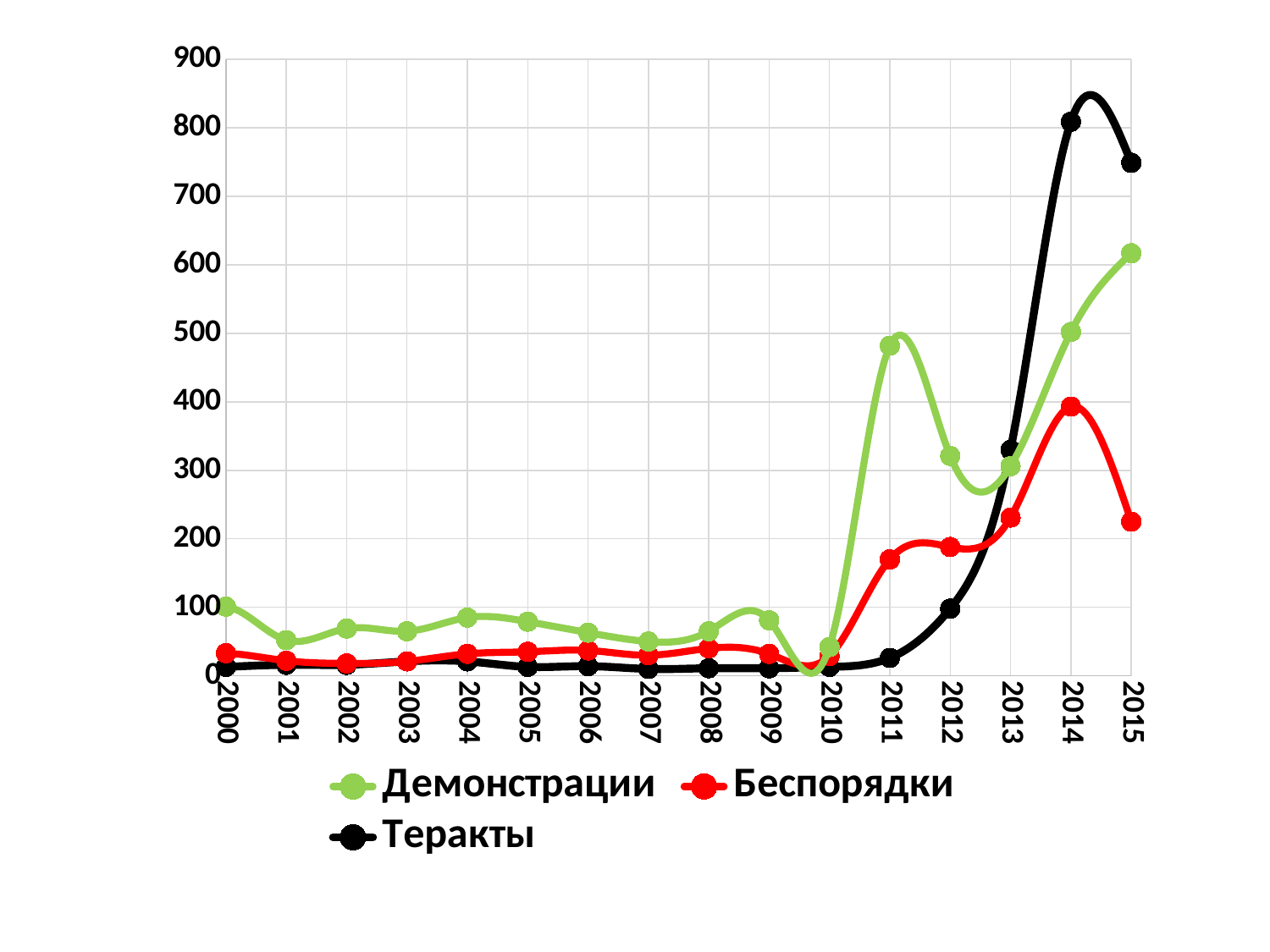
Is the value for Демонстрации in 2010 greater or less than 100? less In which year does the Беспорядки series reach its highest value? 2014 How many years are plotted along the x axis? 16 In which year does the Теракты series reach its highest value? 2014 Which series has the highest value in 2015? Теракты In which year does the Демонстрации series reach its highest value? 2015 How many series does the legend list? 3 Is the value for Теракты in 2014 greater or less than 700? greater Is the value for Беспорядки in 2015 greater or less than 200? greater Which series has the highest value in 2011? Демонстрации What kind of chart is shown on the slide? line chart Does the Теракты series rise or fall from 2010 to 2014? rise